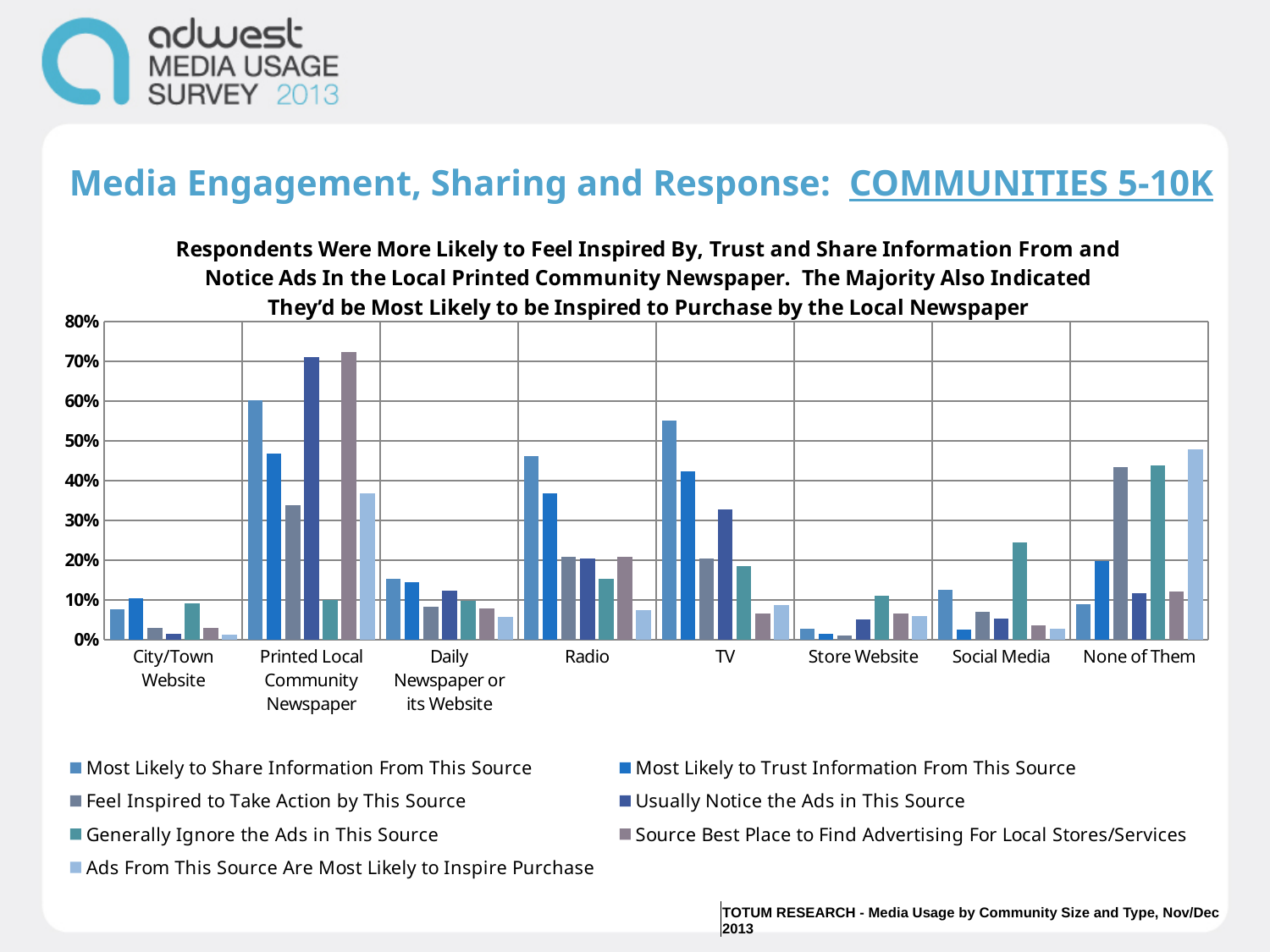
Is the value for 'Most Likely to Share Information From This Source' for TV greater or less than 50%? greater What kind of chart is shown on the slide? Bar chart Is the value for 'Most Likely to Trust Information From This Source' for City/Town Website greater or less than 20%? less Is the value for 'Ads From This Source Are Most Likely to Inspire Purchase' for None of Them greater or less than 40%? greater Which category has the highest value for 'Most Likely to Share Information From This Source'? Printed Local Community Newspaper How many media source categories are shown along the x axis? 8 Which is larger for 'Generally Ignore the Ads in This Source': Printed Local Community Newspaper or None of Them? None of Them Which series is listed last in the legend? Ads From This Source Are Most Likely to Inspire Purchase How many series does the legend list? 7 Which is larger for 'Most Likely to Trust Information From This Source': Radio or TV? TV